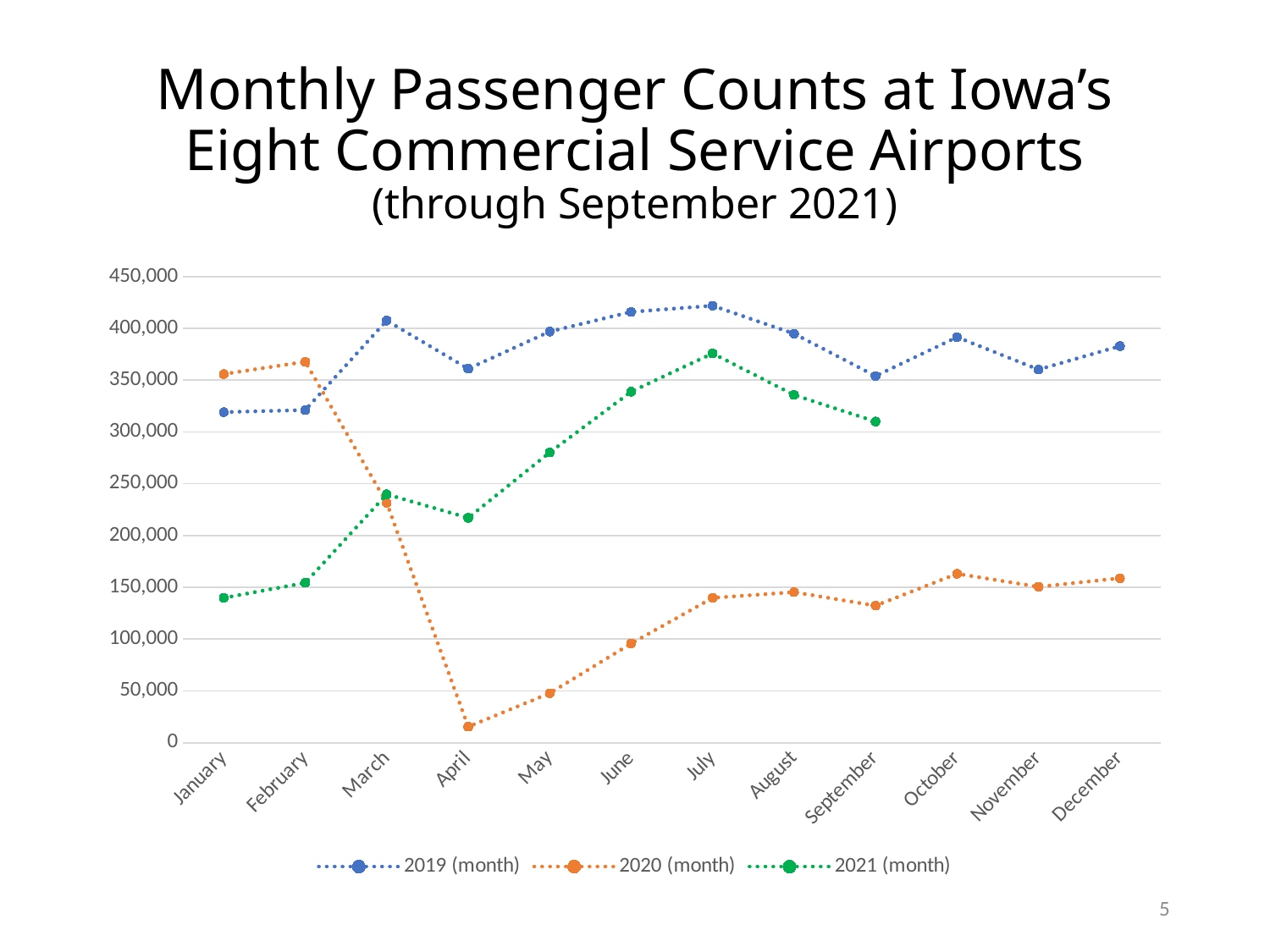
In which month is the 2020 (month) series at its lowest? April How many series does the legend list? 3 In June, which series has the larger value, 2020 (month) or 2021 (month)? 2021 (month) Does the 2021 (month) series rise or fall from January to July? Rise In which month is the 2021 (month) series at its lowest? January How many months are shown along the x axis? 12 Is the value for 2019 (month) in July greater or less than 400,000? greater In which month is the 2021 (month) series at its highest? July What kind of chart is shown on the slide? Line chart Is the value for 2021 (month) in May greater or less than 300,000? less How many data points are plotted for the 2021 (month) series? 9 Is the value for 2020 (month) in April greater or less than 50,000? less